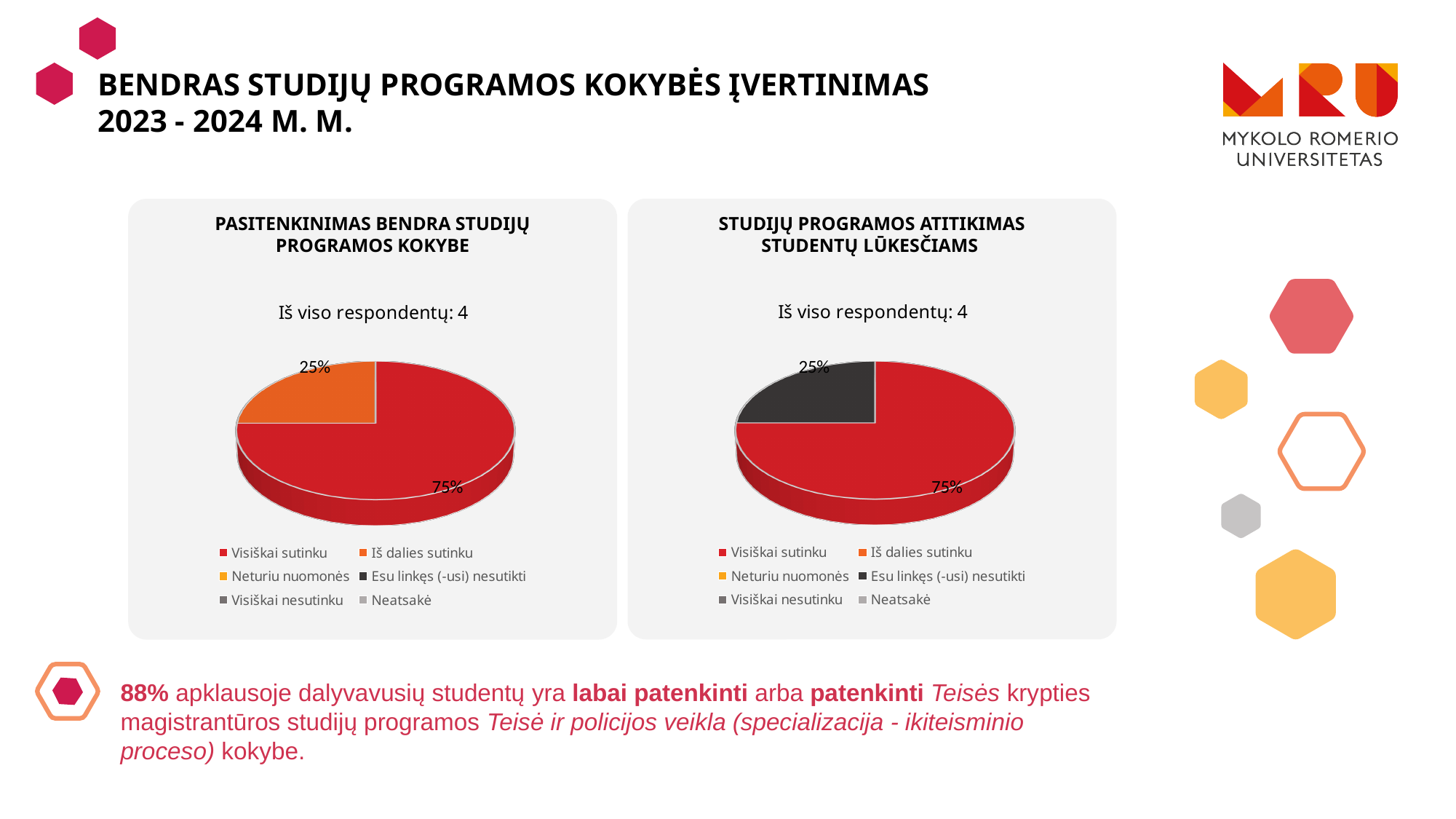
How many entries does the legend of the right chart list? 6 According to the left chart, how many respondents were there in total? 4 In the chart titled "STUDIJŲ PROGRAMOS ATITIKIMAS STUDENTŲ LŪKESČIAMS", what share of the pie is "Visiškai sutinku"? 75% What type of chart is used in the chart titled "PASITENKINIMAS BENDRA STUDIJŲ PROGRAMOS KOKYBE"? Pie chart In the chart titled "PASITENKINIMAS BENDRA STUDIJŲ PROGRAMOS KOKYBE", what share of the pie is "Visiškai sutinku"? 75% In the left chart, which category has the largest slice? Visiškai sutinku In the right chart, which is larger: "Visiškai sutinku" or "Esu linkęs (-usi) nesutikti"? Visiškai sutinku In the chart titled "PASITENKINIMAS BENDRA STUDIJŲ PROGRAMOS KOKYBE", what share of the pie is "Iš dalies sutinku"? 25% In the left chart, what is the difference between the "Visiškai sutinku" and "Iš dalies sutinku" shares? 50% In the right chart, which category has the smallest visible slice? Esu linkęs (-usi) nesutikti How many slices are visible in the left chart? 2